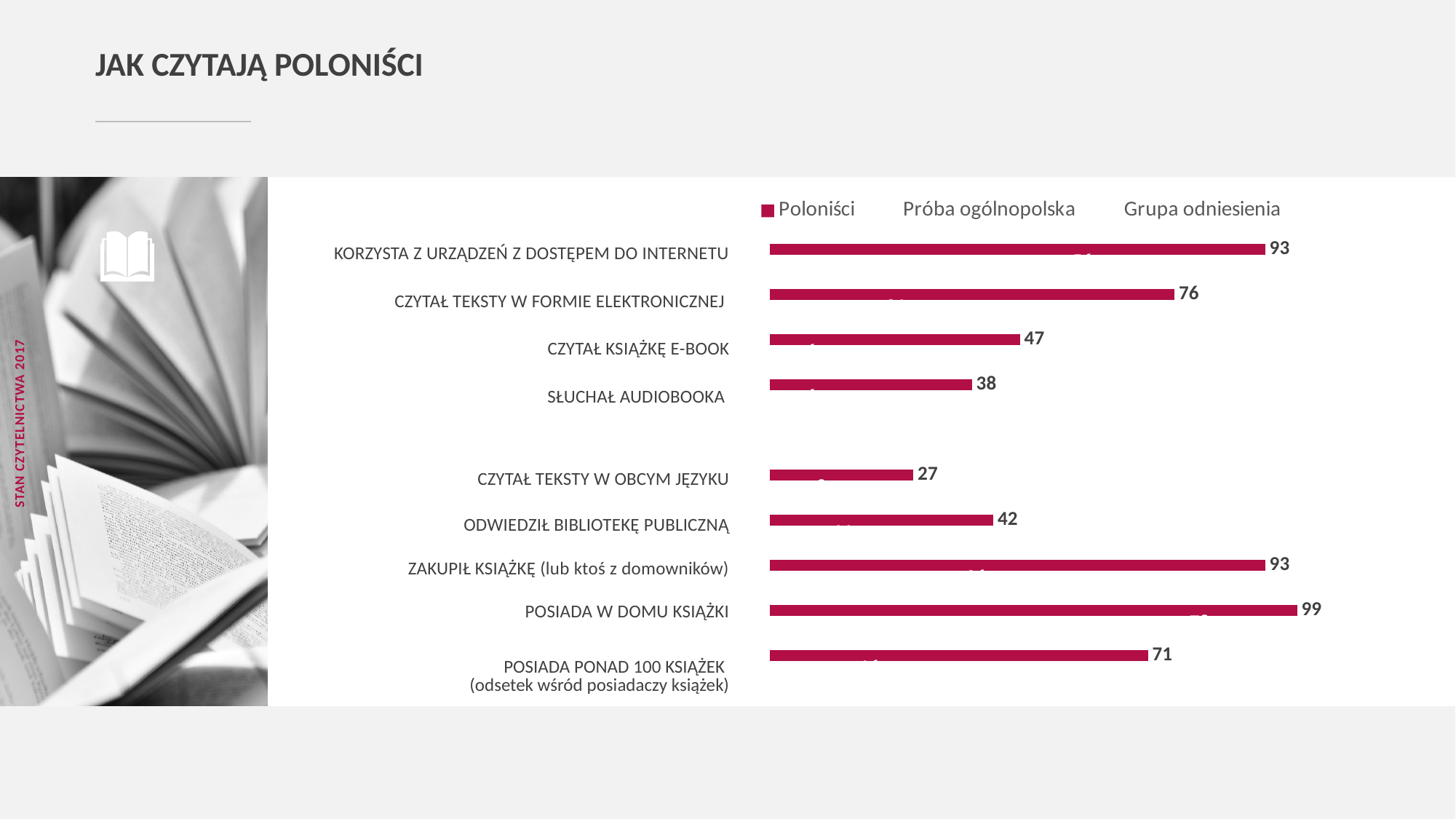
What is the Poloniści value for CZYTAŁ TEKSTY W FORMIE ELEKTRONICZNEJ? 76 What is the title of the slide containing the chart? JAK CZYTAJĄ POLONIŚCI Which category has the highest Poloniści value? POSIADA W DOMU KSIĄŻKI What is the Poloniści value for POSIADA PONAD 100 KSIĄŻEK? 71 What is the Poloniści value for KORZYSTA Z URZĄDZEŃ Z DOSTĘPEM DO INTERNETU? 93 Which category has the lowest Poloniści value? CZYTAŁ TEKSTY W OBCYM JĘZYKU How many series does the legend list? 3 What is the Poloniści value for SŁUCHAŁ AUDIOBOOKA? 38 What is the difference between the Poloniści values for CZYTAŁ KSIĄŻKĘ E-BOOK and SŁUCHAŁ AUDIOBOOKA? 9 How many categories are shown in the chart? 9 What kind of chart is shown on the slide? Bar chart Which has a larger Poloniści value: ODWIEDZIŁ BIBLIOTEKĘ PUBLICZNĄ or CZYTAŁ TEKSTY W OBCYM JĘZYKU? ODWIEDZIŁ BIBLIOTEKĘ PUBLICZNĄ